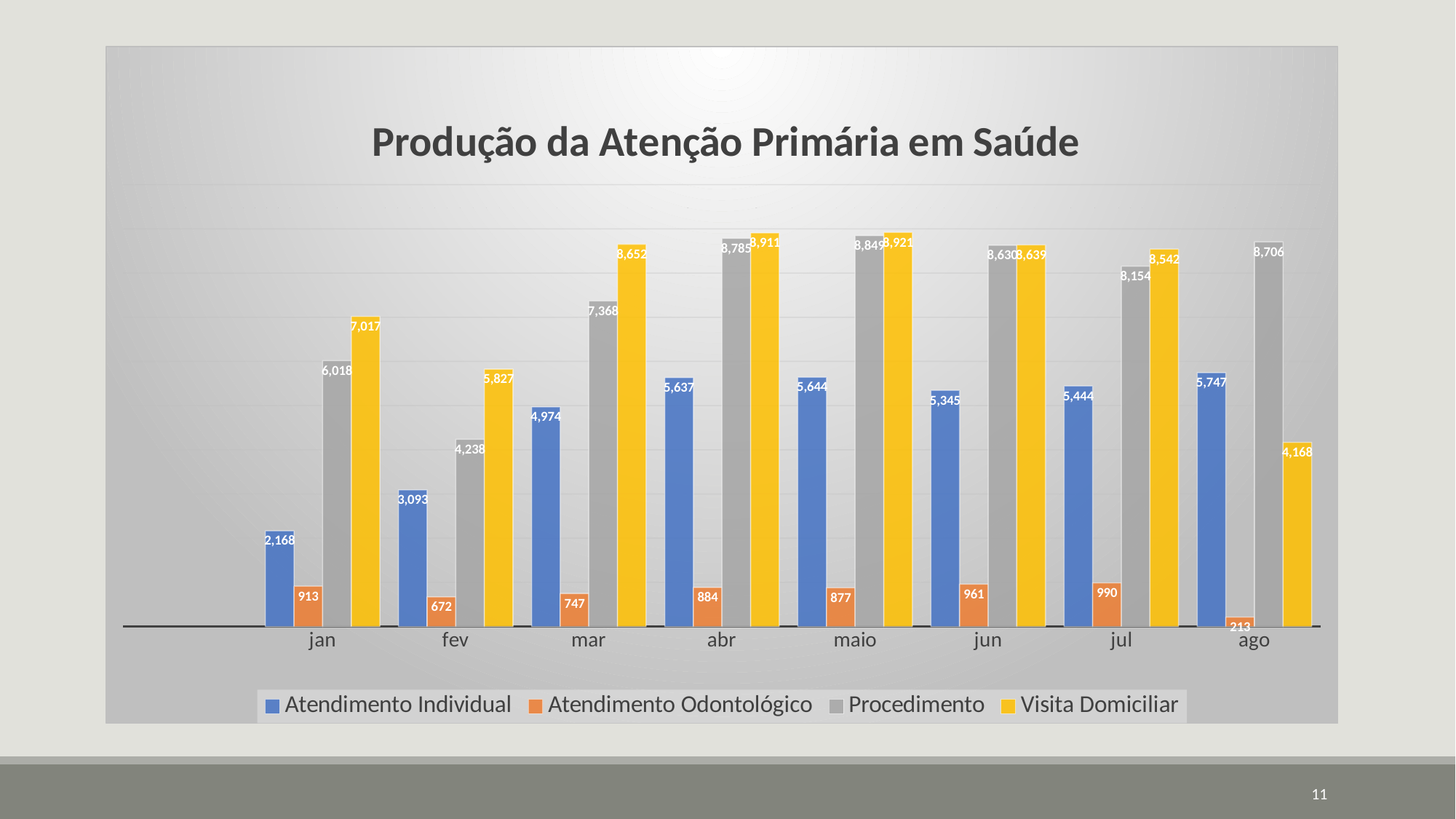
What kind of chart is shown? bar chart What is the difference between Procedimento in jan and in fev? 1,780 What is the value of Procedimento in jul? 8,154 In which month is Atendimento Odontológico highest? jul How many series does the legend list? 4 What is the value of Atendimento Individual in jan? 2,168 How many months are shown on the x axis? 8 In ago, which is larger: Procedimento or Visita Domiciliar? Procedimento What is the value of Visita Domiciliar in mar? 8,652 Does Atendimento Individual rise or fall from jan to mar? rise In which month is Atendimento Individual lowest? jan What is the value of Atendimento Odontológico in ago? 213